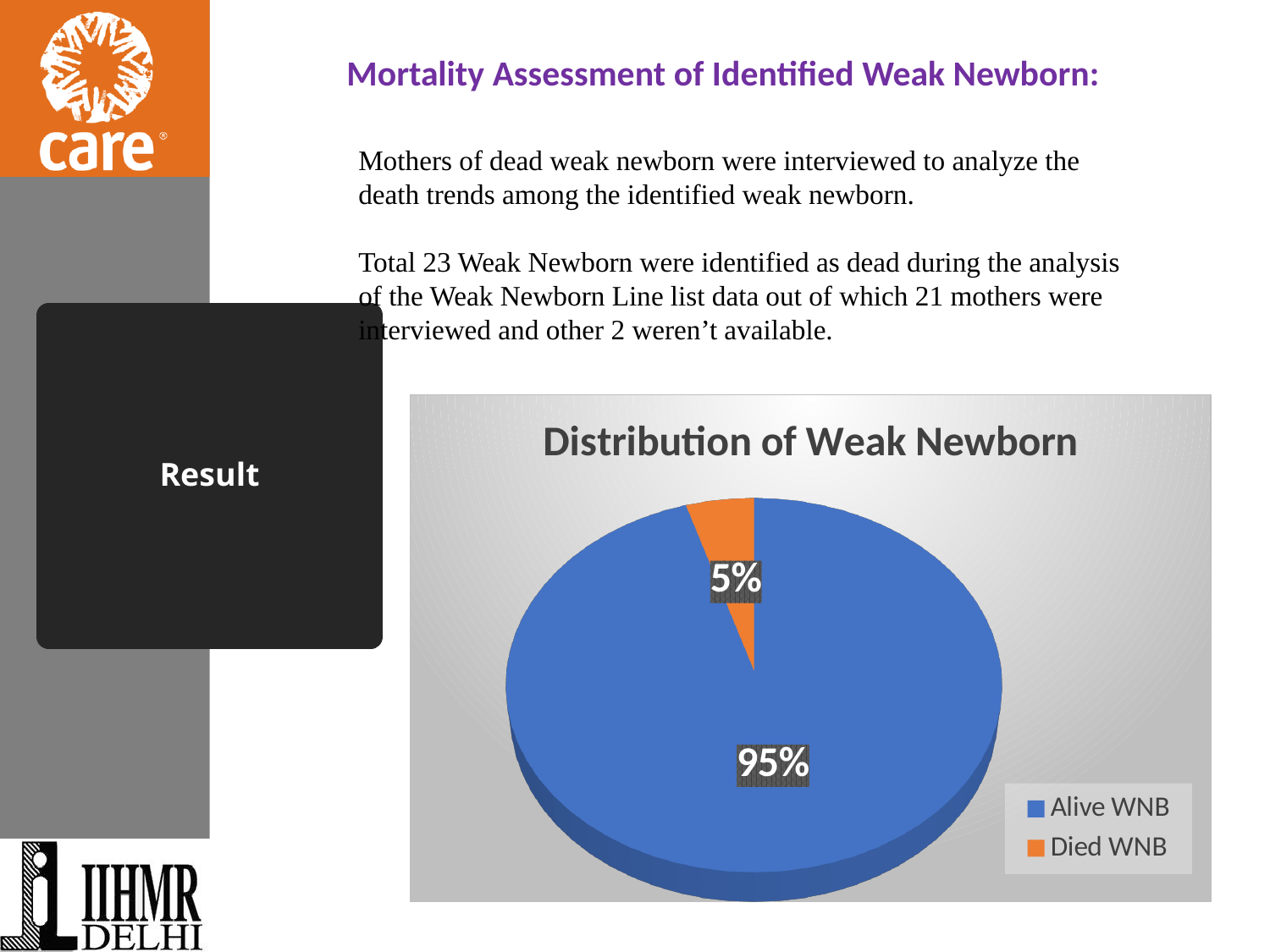
Which category has the smallest slice of the pie? Died WNB What share of the pie is Alive WNB? 95% What is the difference in percentage points between Alive WNB and Died WNB? 90 percentage points Which category has the largest slice of the pie? Alive WNB What kind of chart is shown on the slide? Pie chart What colour is the Died WNB slice? Orange How many slices does the pie chart have? 2 What share of the pie is Died WNB? 5% Which is larger, the share for Alive WNB or the share for Died WNB? Alive WNB How many categories does the legend list? 2 What is the title of the chart? Distribution of Weak Newborn